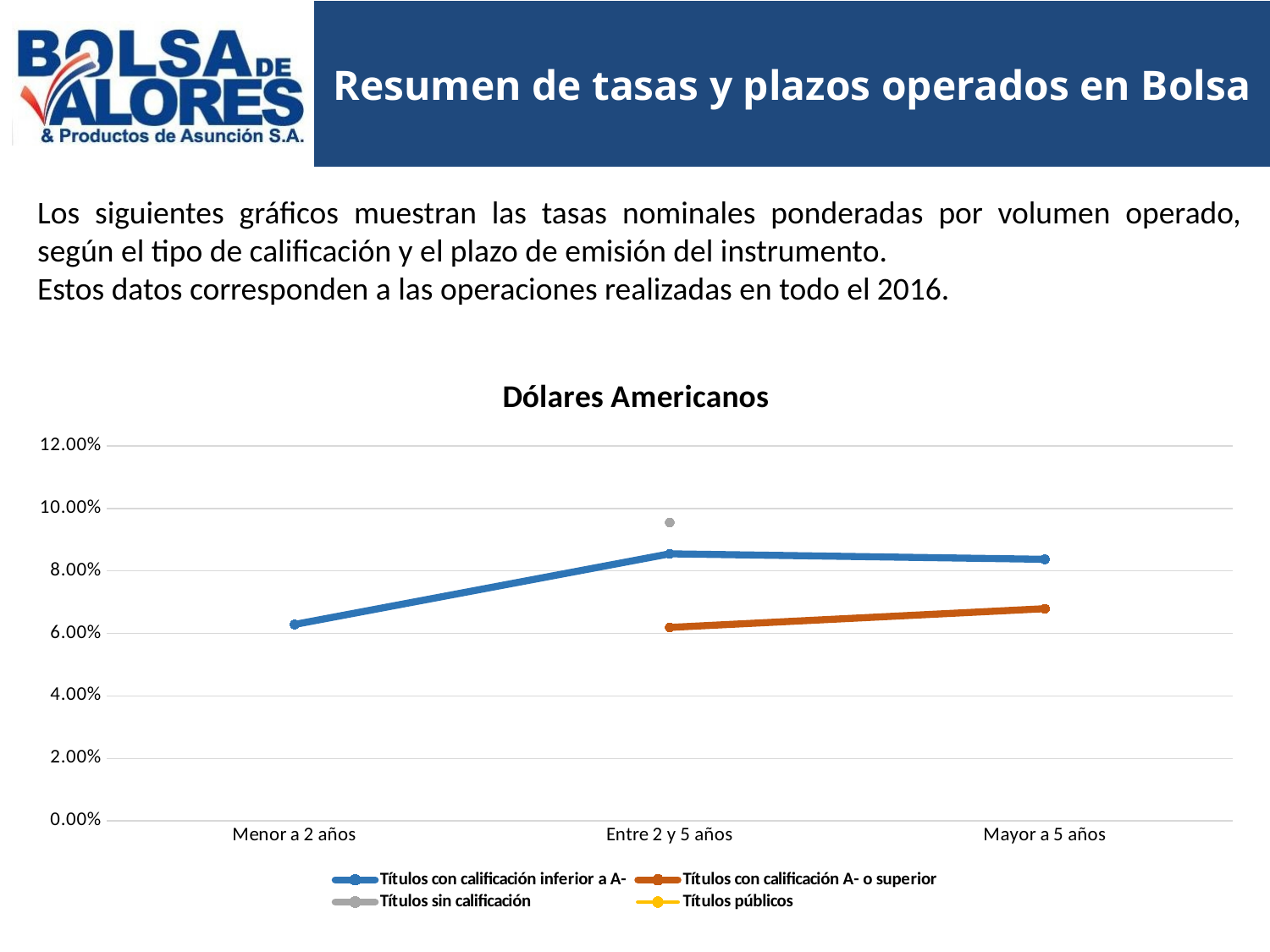
What kind of chart is shown on the slide? line chart At Entre 2 y 5 años, which is larger: Títulos sin calificación or Títulos con calificación inferior a A-? Títulos sin calificación Is the value for Títulos sin calificación at Entre 2 y 5 años greater or less than 10.00%? less Is the value for Títulos con calificación A- o superior at Mayor a 5 años greater or less than 8.00%? less Is the value for Títulos con calificación inferior a A- at Entre 2 y 5 años greater or less than 8.00%? greater For Títulos con calificación inferior a A-, which category has the lowest value? Menor a 2 años What is the title of the chart? Dólares Americanos How many series does the legend list? 4 How many categories are shown on the x axis? 3 At Entre 2 y 5 años, which is larger: Títulos con calificación inferior a A- or Títulos con calificación A- o superior? Títulos con calificación inferior a A- Does the Títulos con calificación A- o superior line rise or fall from Entre 2 y 5 años to Mayor a 5 años? rise